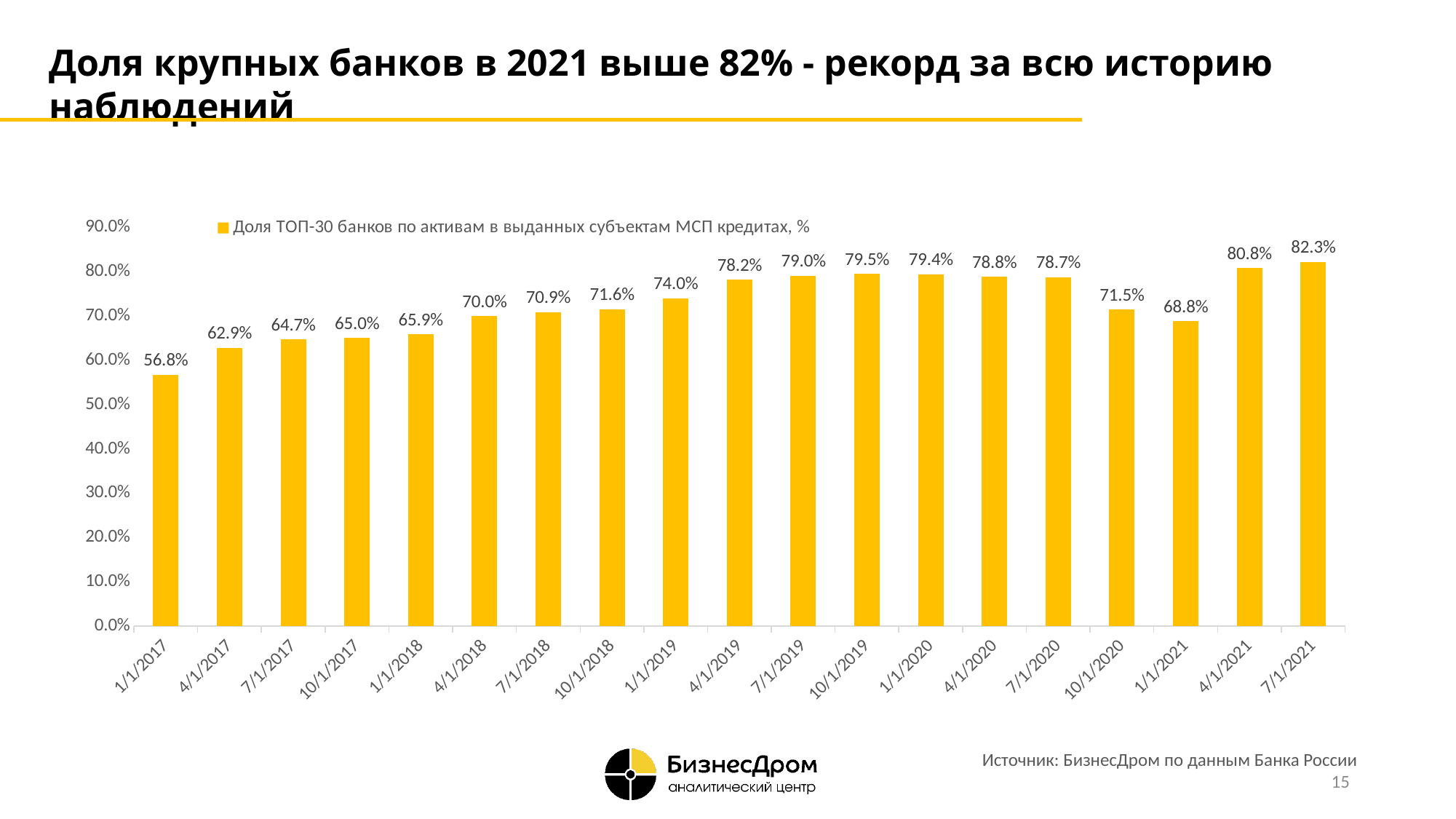
Is the value for 1/1/2019 greater or less than 70.0%? greater What is the legend entry of the series shown? Доля ТОП-30 банков по активам в выданных субъектам МСП кредитах, % What kind of chart is shown on the slide? bar chart Which date has the highest value? 7/1/2021 Which date has the lowest value? 1/1/2017 What is the value for 7/1/2021? 82.3% How many series does the legend list? 1 What is the value for 10/1/2020? 71.5% What is the difference between the values for 7/1/2021 and 1/1/2017? 25.5% How many bars are shown in the chart? 19 What is the value for 1/1/2017? 56.8% Which is larger, the value for 1/1/2021 or the value for 4/1/2021? 4/1/2021